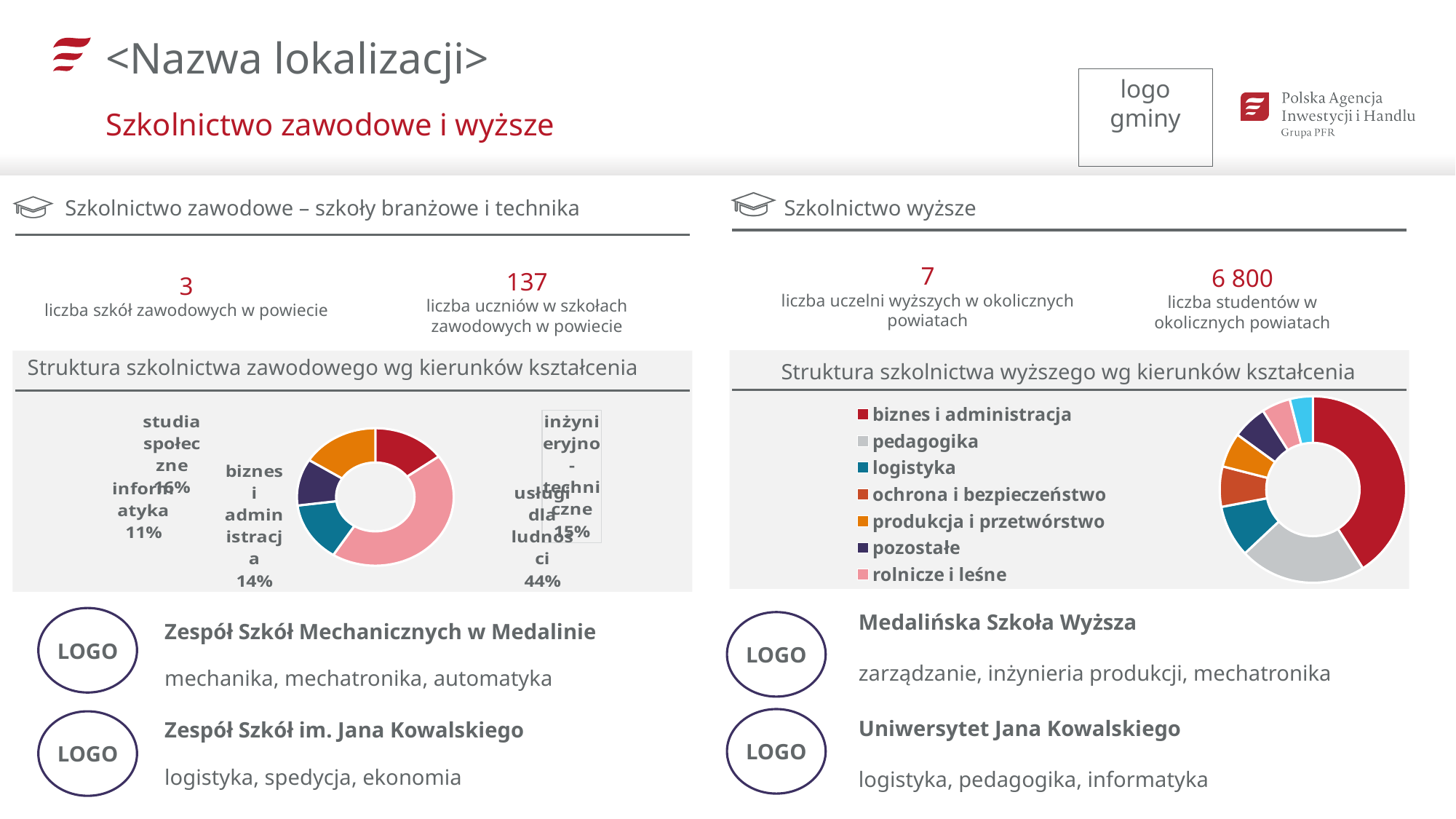
In the chart 'Struktura szkolnictwa wyższego wg kierunków kształcenia', how many entries does the legend list? 7 In the chart 'Struktura szkolnictwa wyższego wg kierunków kształcenia', which category has the largest slice? biznes i administracja In the chart 'Struktura szkolnictwa zawodowego wg kierunków kształcenia', what share is shown for 'studia społeczne'? 16% In the chart 'Struktura szkolnictwa zawodowego wg kierunków kształcenia', what share is shown for 'usługi dla ludności'? 44% In the chart 'Struktura szkolnictwa zawodowego wg kierunków kształcenia', how many categories are shown? 5 In the chart 'Struktura szkolnictwa zawodowego wg kierunków kształcenia', which is larger: 'biznes i administracja' or 'inżynieryjno-techniczne'? inżynieryjno-techniczne In the chart 'Struktura szkolnictwa zawodowego wg kierunków kształcenia', which category has the smallest share? informatyka What type of chart is 'Struktura szkolnictwa wyższego wg kierunków kształcenia'? Doughnut (pie) chart In the chart 'Struktura szkolnictwa zawodowego wg kierunków kształcenia', which category has the largest share? usługi dla ludności In the chart 'Struktura szkolnictwa wyższego wg kierunków kształcenia', which legend entry is listed first? biznes i administracja What type of chart is 'Struktura szkolnictwa zawodowego wg kierunków kształcenia'? Doughnut (pie) chart In the chart 'Struktura szkolnictwa zawodowego wg kierunków kształcenia', what is the difference in percentage points between 'studia społeczne' and 'informatyka'? 5 percentage points